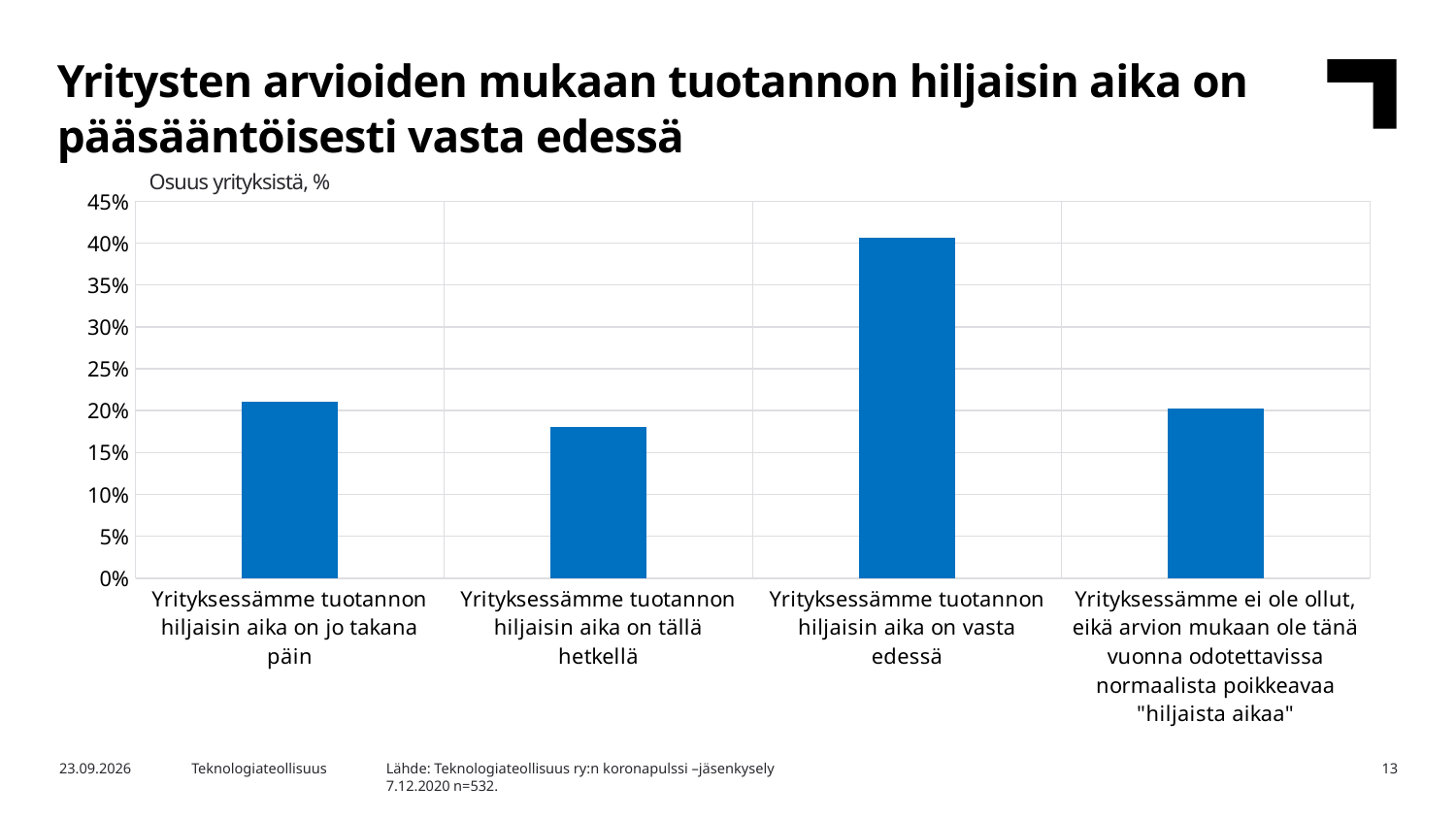
What is the highest value shown on the vertical axis? 45% Which category has the highest value? Yrityksessämme tuotannon hiljaisin aika on vasta edessä What is the label shown above the vertical axis of the chart? Osuus yrityksistä, % Which is larger: the value for "Yrityksessämme tuotannon hiljaisin aika on vasta edessä" or the value for "Yrityksessämme tuotannon hiljaisin aika on jo takana päin"? Yrityksessämme tuotannon hiljaisin aika on vasta edessä Is the value for "Yrityksessämme tuotannon hiljaisin aika on jo takana päin" greater or less than 25%? less Which is larger: the value for "Yrityksessämme tuotannon hiljaisin aika on tällä hetkellä" or the value for "Yrityksessämme tuotannon hiljaisin aika on vasta edessä"? Yrityksessämme tuotannon hiljaisin aika on vasta edessä Is the value for "Yrityksessämme ei ole ollut, eikä arvion mukaan ole tänä vuonna odotettavissa normaalista poikkeavaa 'hiljaista aikaa'" greater or less than 25%? less How many categories (bars) does the chart show? 4 Is the value for "Yrityksessämme tuotannon hiljaisin aika on tällä hetkellä" greater or less than 20%? less What kind of chart is shown on the slide? bar chart